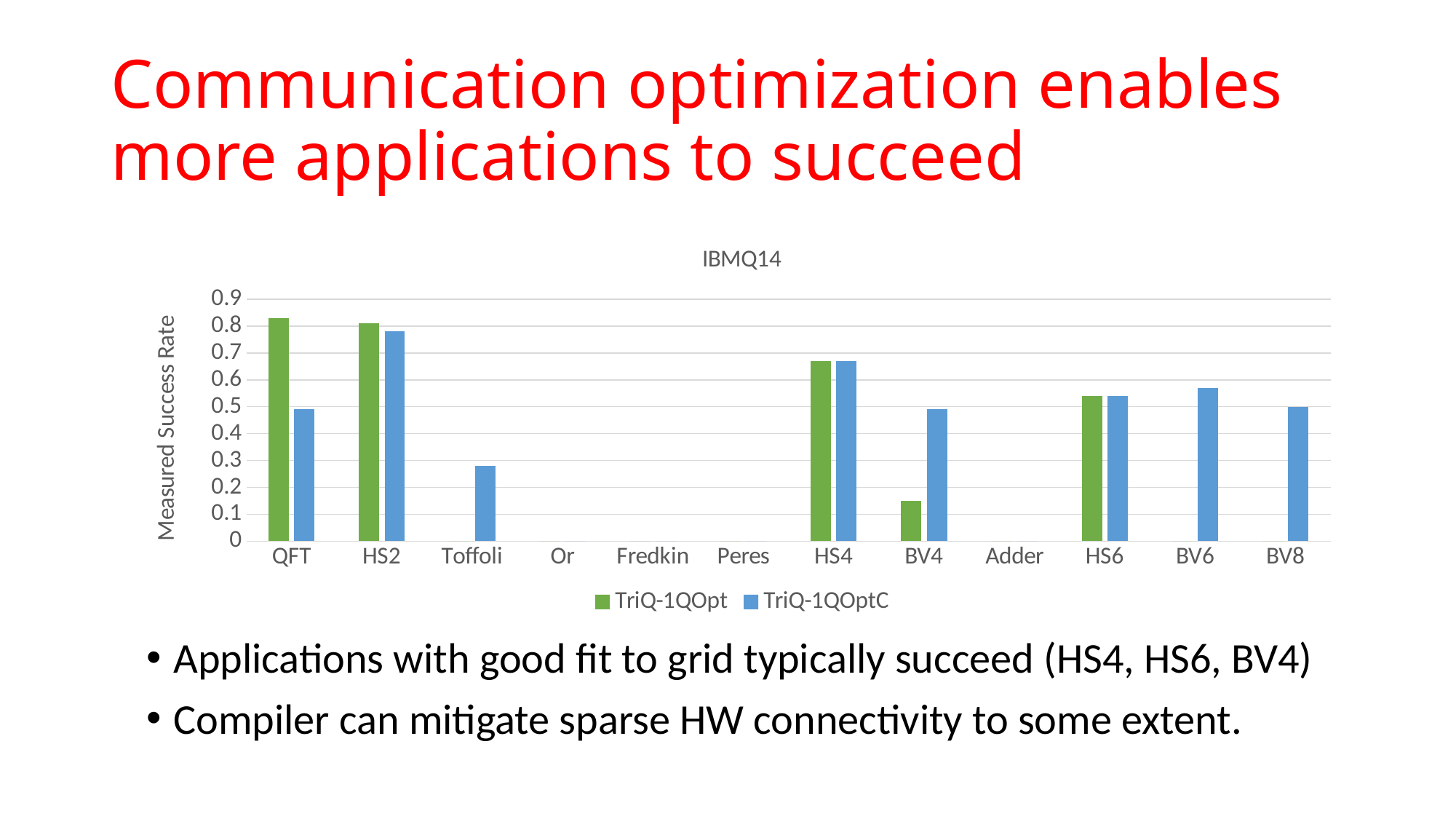
What is the title of the chart? IBMQ14 For BV4, which series has the larger value, TriQ-1QOpt or TriQ-1QOptC? TriQ-1QOptC Is the TriQ-1QOptC value for Toffoli greater or less than 0.3? less Is the TriQ-1QOptC value for HS4 greater or less than 0.6? greater What is the label of the y axis? Measured Success Rate What kind of chart is shown on the slide? bar chart How many series does the legend list? 2 For QFT, which series has the larger value, TriQ-1QOpt or TriQ-1QOptC? TriQ-1QOpt Is the TriQ-1QOpt value for QFT greater or less than 0.8? greater Which category has the highest TriQ-1QOptC value? HS2 How many categories are shown on the x axis? 12